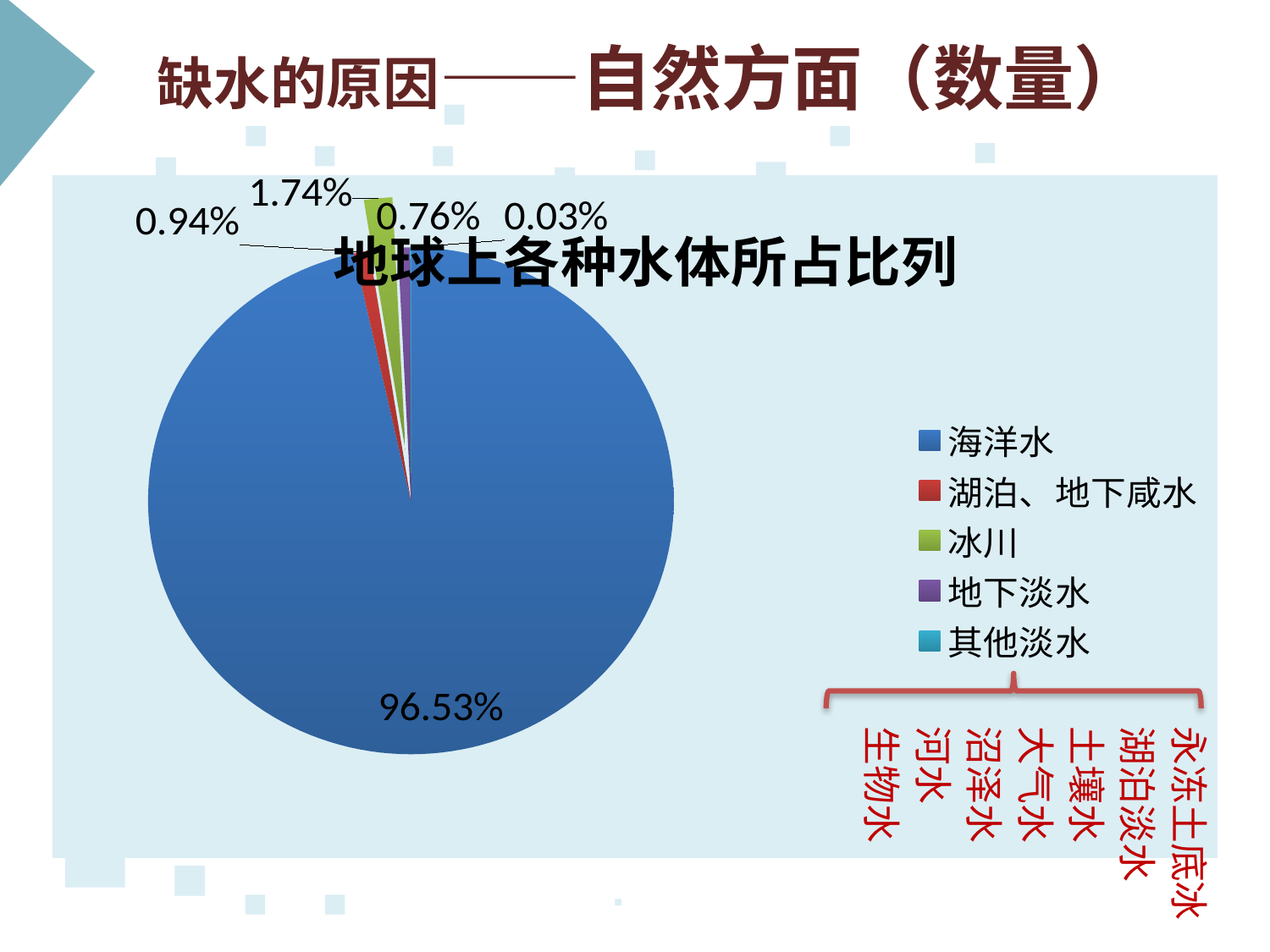
How many categories does the legend of the pie chart list? 5 What is the difference between the share of 冰川 and the share of 湖泊、地下咸水? 0.80% What percentage is shown for 湖泊、地下咸水? 0.94% Which is larger, the share of 冰川 or the share of 地下淡水? 冰川 What percentage of the pie does 海洋水 account for? 96.53% Which category has the smallest share of the pie? 其他淡水 What percentage is shown for 其他淡水? 0.03% What percentage is shown for 冰川? 1.74% What type of chart is shown on the slide? pie chart What percentage is shown for 地下淡水? 0.76% Which category has the largest share of the pie? 海洋水 What is the title of the chart? 地球上各种水体所占比列